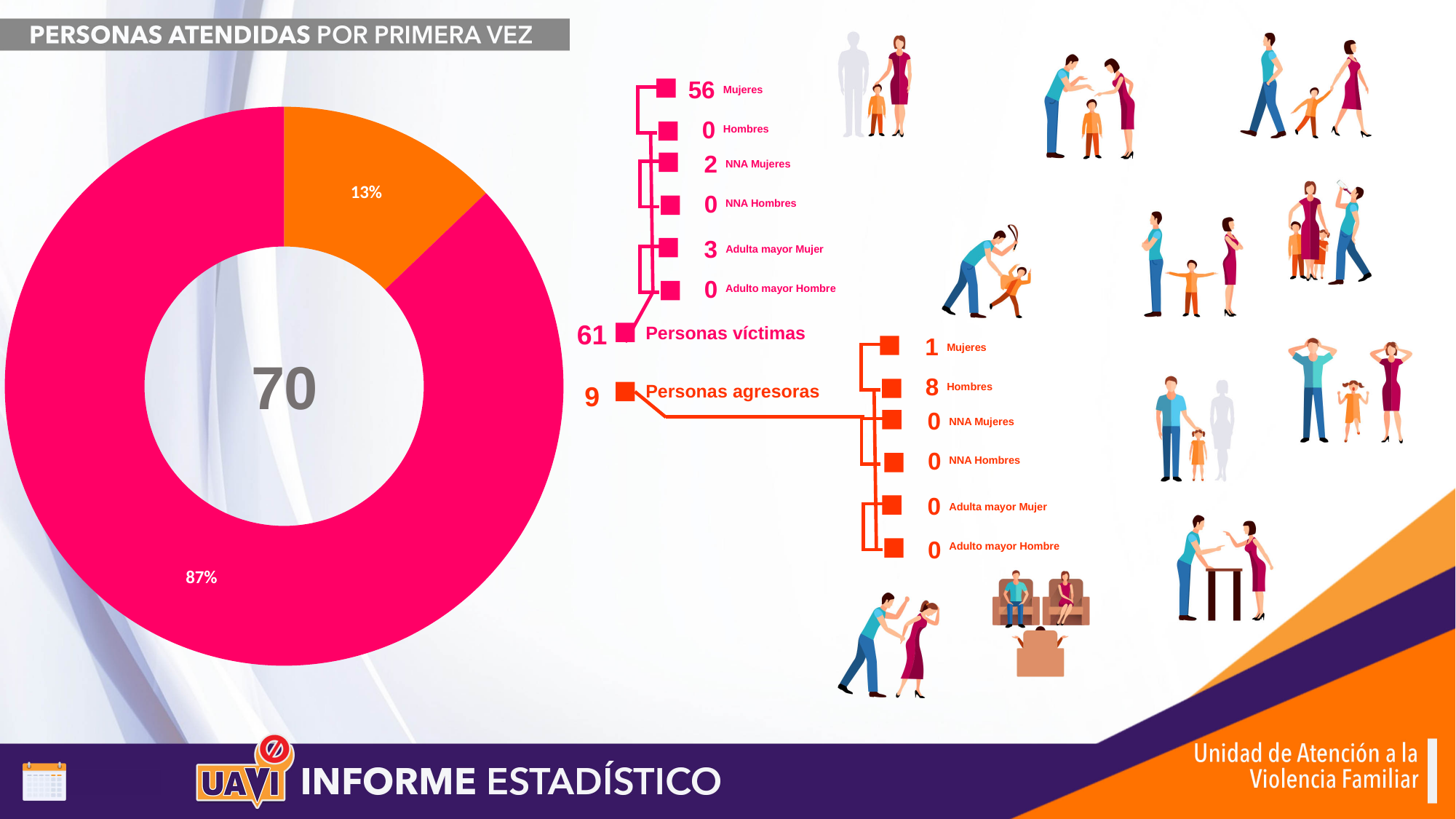
Which slice of the donut chart is larger, Personas víctimas or Personas agresoras? Personas víctimas What is the difference in percentage points between the 87% slice and the 13% slice of the donut chart? 74 percentage points What total number is shown in the centre of the donut chart? 70 How many Personas agresoras are reported next to the donut chart? 9 What percentage of the donut chart does the pink slice (Personas víctimas) represent? 87% What kind of chart is shown on the slide? Donut (pie) chart How many Hombres are listed under Personas agresoras? 8 What is the title of the slide containing the donut chart? PERSONAS ATENDIDAS POR PRIMERA VEZ How many Mujeres are listed under Personas víctimas? 56 What percentage of the donut chart does the orange slice (Personas agresoras) represent? 13% How many Personas víctimas are reported next to the donut chart? 61 How many slices does the donut chart have? 2